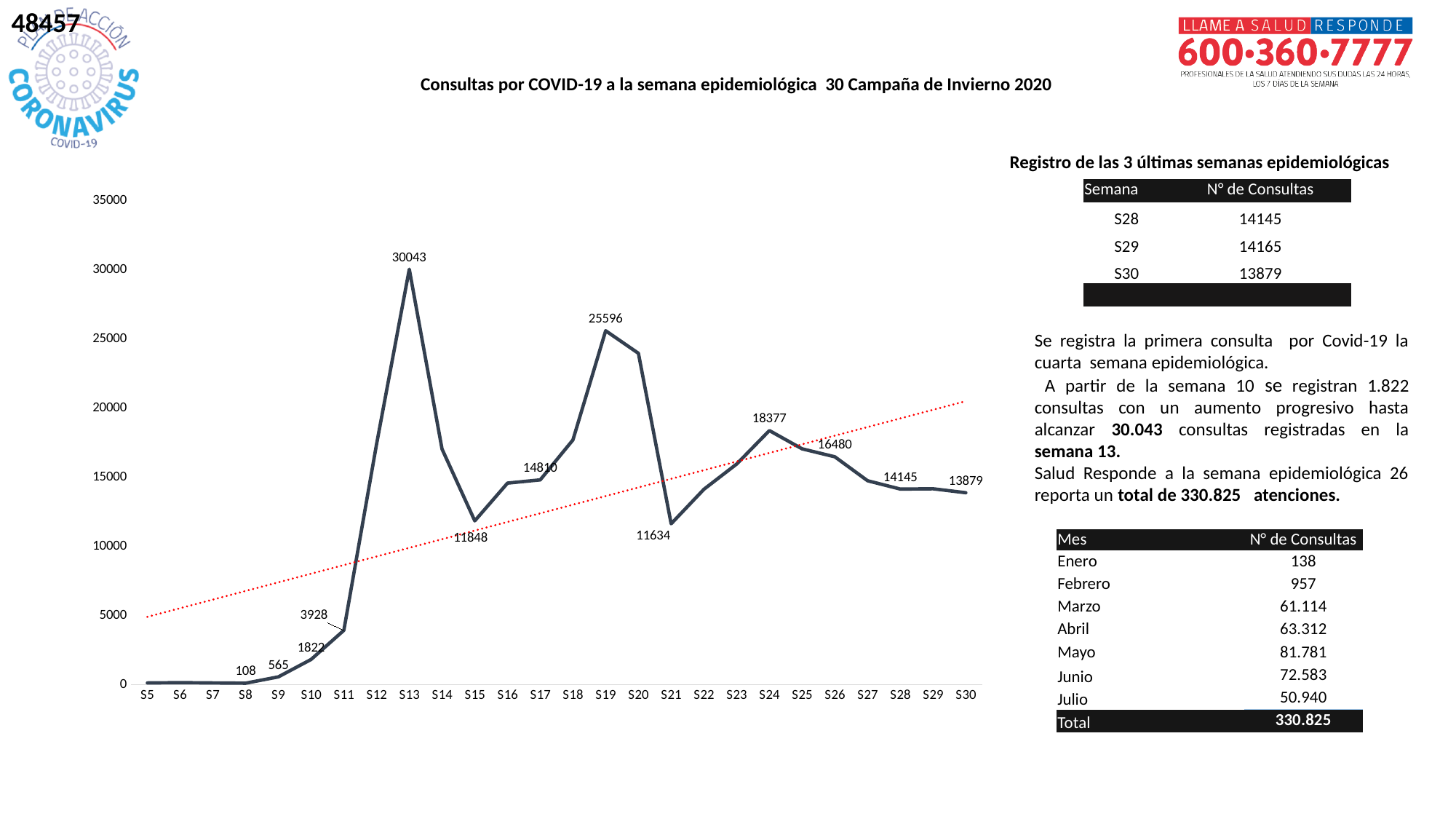
What kind of chart is shown on the slide? line chart How many weeks are plotted on the x axis of the chart? 26 What is the value for S13 in the chart? 30043 Which week has the highest number of consultations in the chart? S13 What is the value for S11 in the chart? 3928 Is the value for S20 greater or less than 20000? greater What is the difference between the values for S13 and S19? 4447 What is the value for S30 in the chart? 13879 Do the values rise or fall from S5 to S13? rise What is the value for S19 in the chart? 25596 Which is larger, the value for S24 or the value for S26? S24 What is the difference between the values for S28 and S30? 266